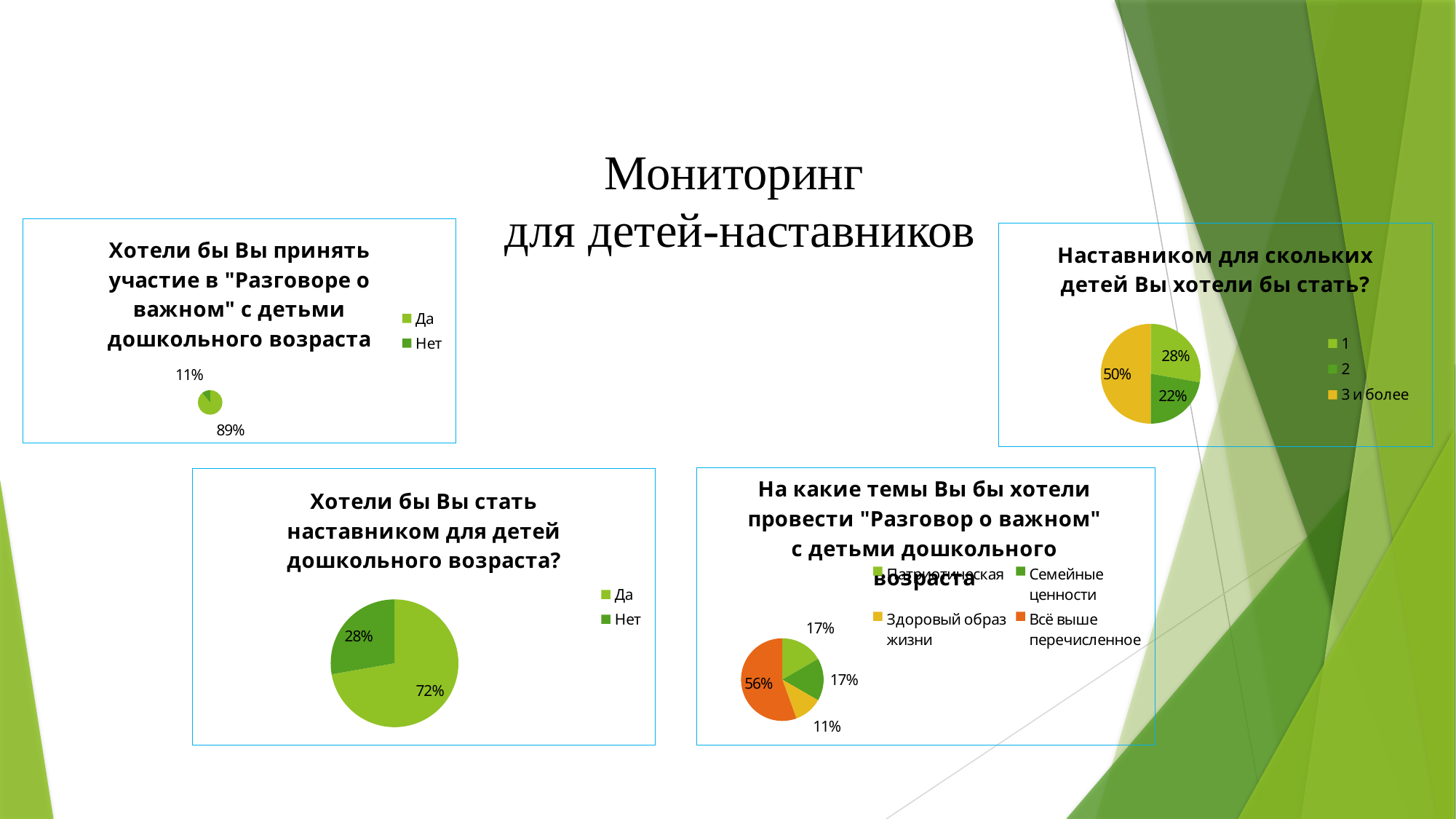
In the chart titled "Хотели бы Вы стать наставником для детей дошкольного возраста?", what is the difference between the "Да" and "Нет" shares? 44% In the chart titled "Наставником для скольких детей Вы хотели бы стать?", how many categories does the legend list? 3 In the chart titled "Хотели бы Вы принять участие в "Разговоре о важном" с детьми дошкольного возраста", what share of respondents answered "Да"? 89% In the chart titled "На какие темы Вы бы хотели провести "Разговор о важном" с детьми дошкольного возраста", what is the share for "Здоровый образ жизни"? 11% In the chart titled "Хотели бы Вы стать наставником для детей дошкольного возраста?", what share answered "Да"? 72% In the chart titled "На какие темы Вы бы хотели провести "Разговор о важном" с детьми дошкольного возраста", which topic has the largest share? Всё выше перечисленное What type of chart is used in the chart titled "Хотели бы Вы стать наставником для детей дошкольного возраста?"? Pie chart In the chart titled "На какие темы Вы бы хотели провести "Разговор о важном" с детьми дошкольного возраста", how many topics does the legend list? 4 In the chart titled "Наставником для скольких детей Вы хотели бы стать?", what is the value for "3 и более"? 50% In the chart titled "Хотели бы Вы принять участие в "Разговоре о важном" с детьми дошкольного возраста", what share of respondents answered "Нет"? 11% In the chart titled "Наставником для скольких детей Вы хотели бы стать?", which category has the smallest share? 2 In the chart titled "Наставником для скольких детей Вы хотели бы стать?", what is the difference between the shares for "1" and "2"? 6%